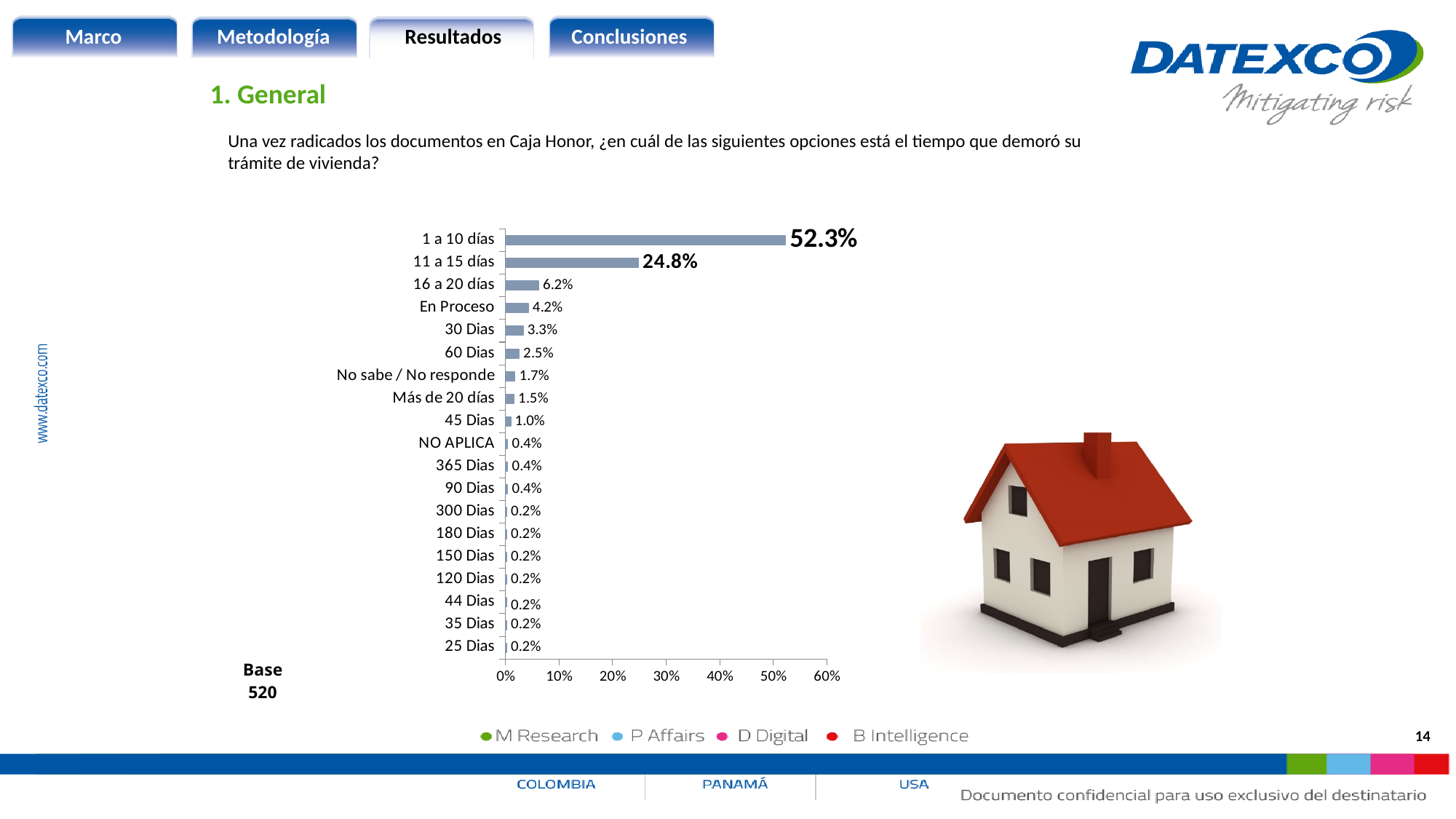
What is the value shown for "En Proceso"? 4.2% Is the value for "1 a 10 días" greater or less than 50%? greater Which is larger, the value for "60 Dias" or the value for "45 Dias"? 60 Dias What is the difference between the values for "16 a 20 días" and "30 Dias"? 2.9% What is the value shown for "No sabe / No responde"? 1.7% What is the base (number of respondents) shown for the chart? 520 Which category has the highest value in the chart? 1 a 10 días What is the difference between the values for "1 a 10 días" and "11 a 15 días"? 27.5% What is the value shown for "11 a 15 días"? 24.8% What kind of chart is shown on the slide? Bar chart How many categories are shown in the chart? 19 What percentage of respondents answered "1 a 10 días"? 52.3%